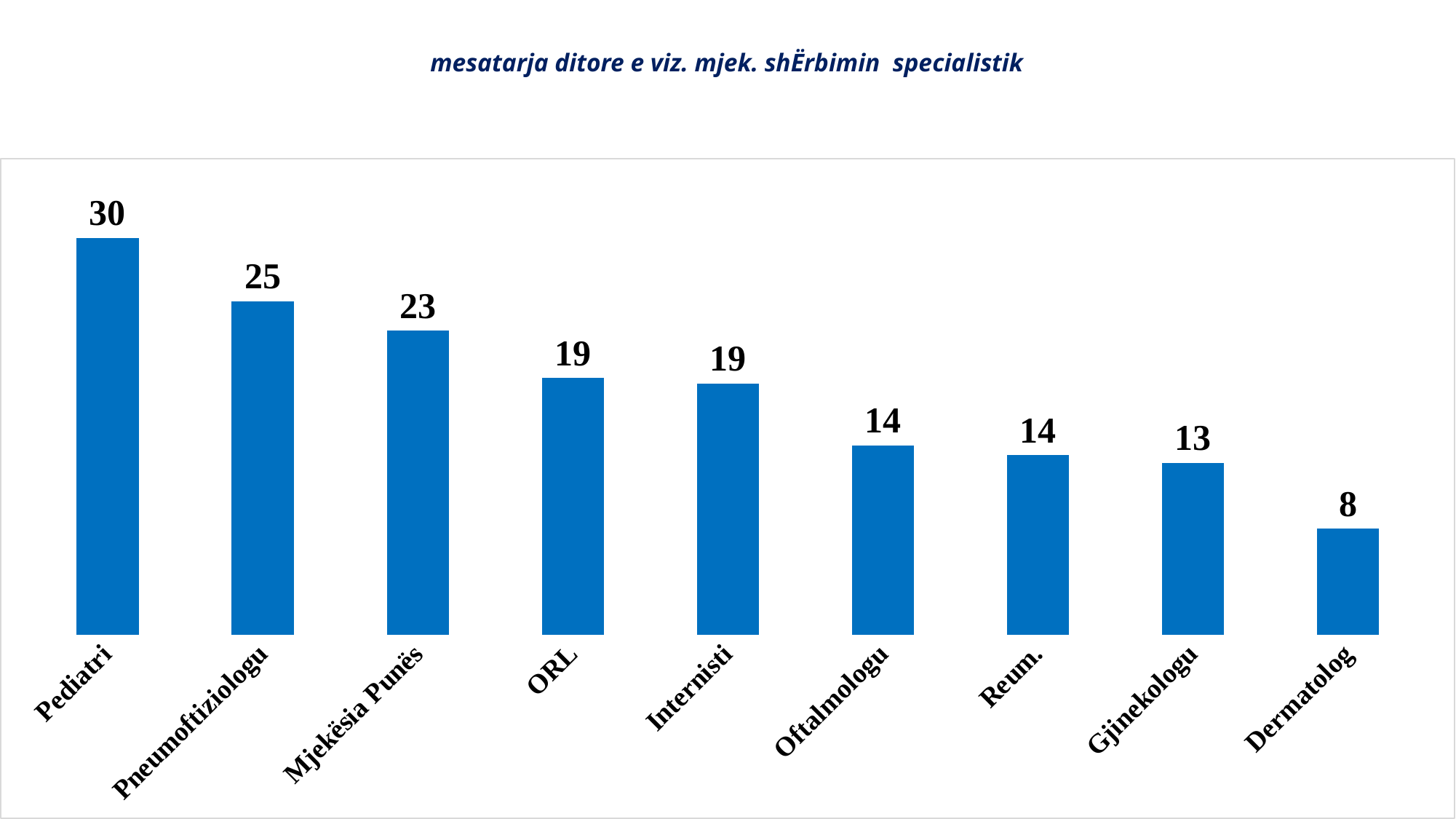
What is the difference between the values for Pediatri and Dermatolog? 22 Do the values rise or fall from left to right along the x axis? Fall What is the value for Pneumoftiziologu? 25 What is the value for Gjinekologu? 13 What is the value for Pediatri? 30 What is the value for Mjekësia Punës? 23 How many categories are shown in the chart? 9 Which category has the lowest value? Dermatolog What is the difference between the values for Pneumoftiziologu and ORL? 6 Which is larger, the value for Oftalmologu or the value for Gjinekologu? Oftalmologu What kind of chart is shown on the slide? Bar chart Which category has the highest value? Pediatri